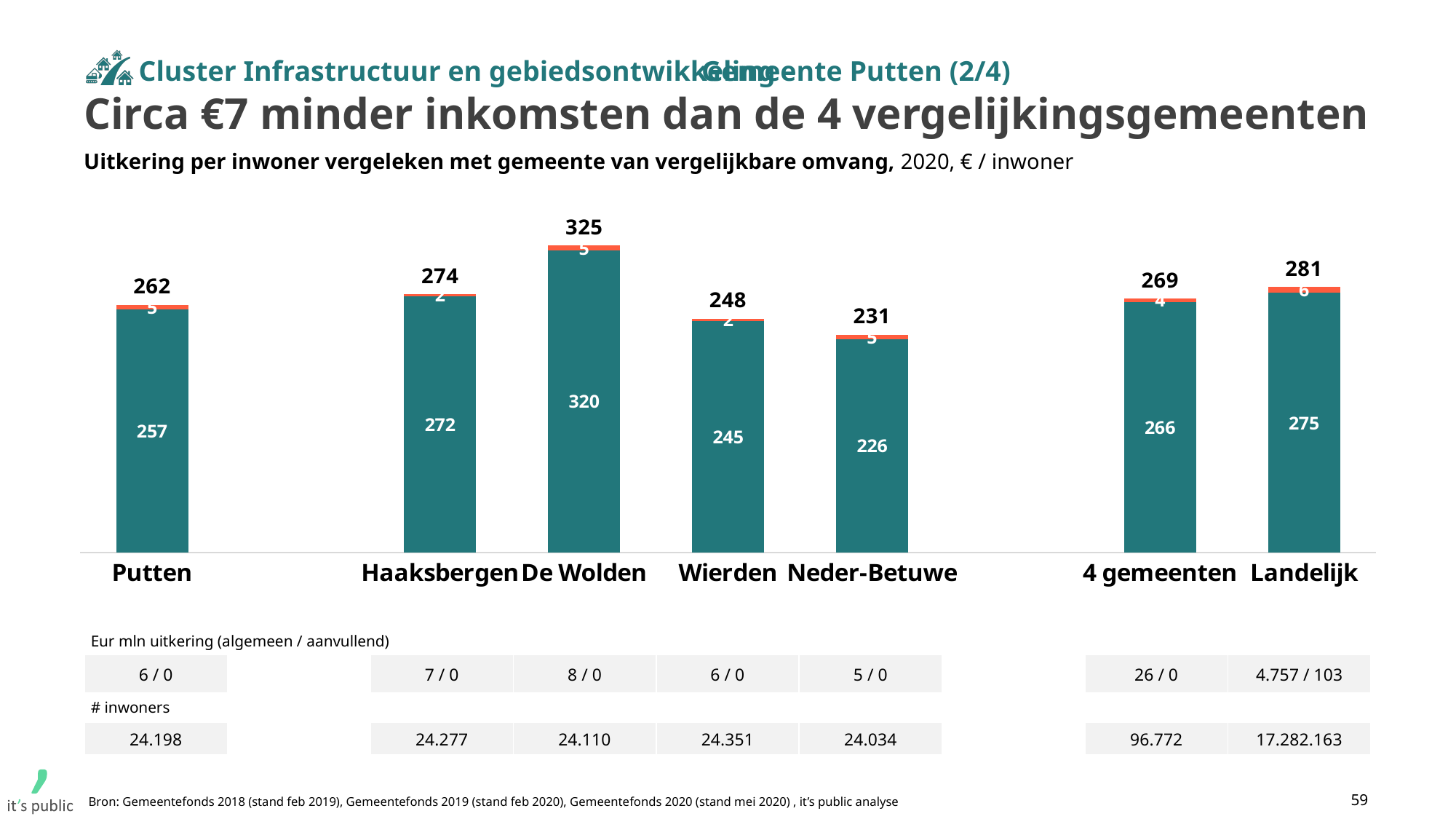
How many categories are shown on the x axis? 7 What is the difference between the totals for De Wolden and 4 gemeenten? 56 What is the value of the teal segment for Neder-Betuwe? 226 What kind of chart is shown on the slide? Stacked bar chart Which category has the highest total? De Wolden What is the difference between the totals for Landelijk and Putten? 19 Which has a larger total, Haaksbergen or Wierden? Haaksbergen What is the total value shown above the bar for 4 gemeenten? 269 What is the value of the large teal segment for De Wolden? 320 What is the value of the small top segment for Landelijk? 6 Which category has the lowest total? Neder-Betuwe What is the total value shown above the bar for Putten? 262